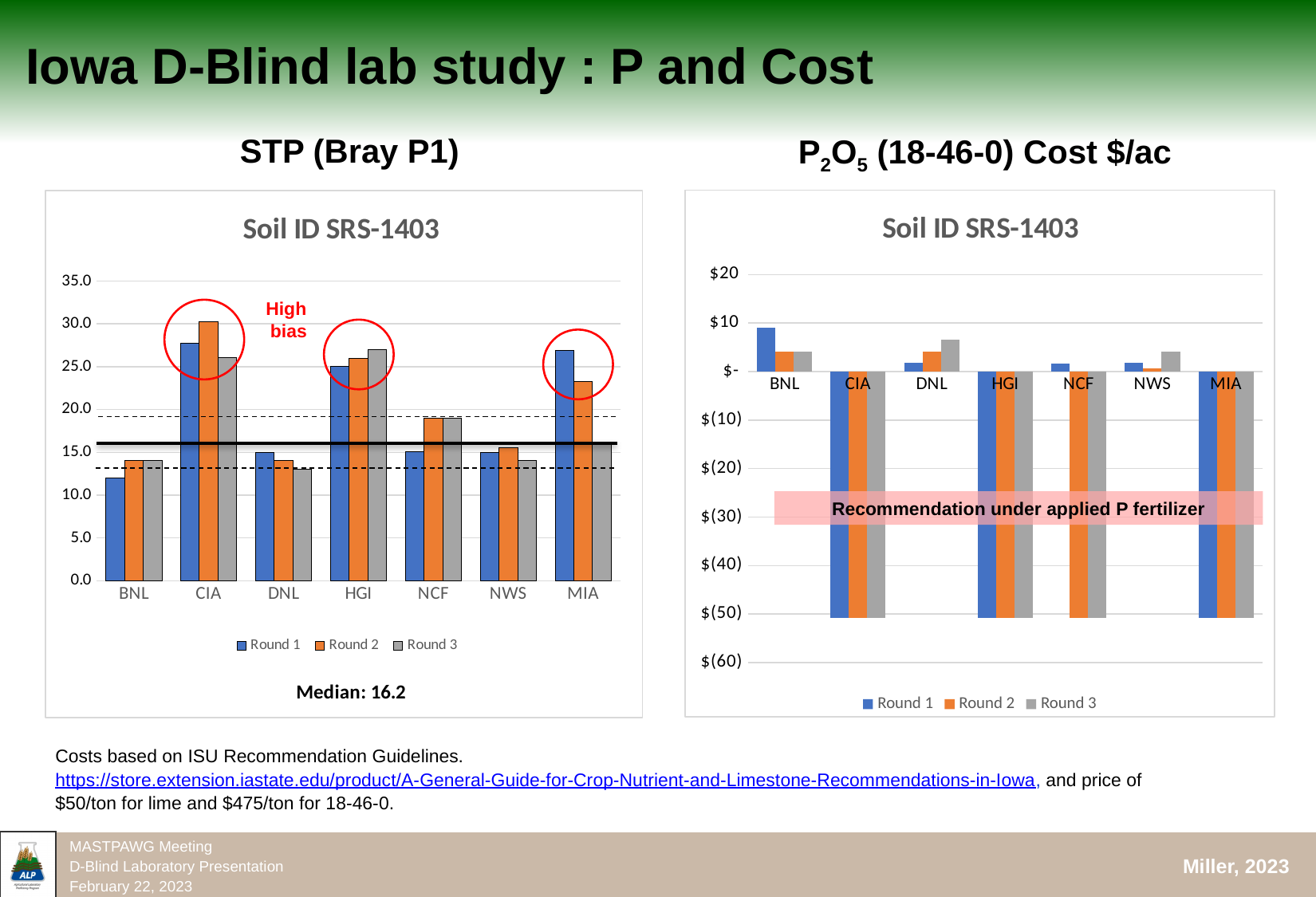
In the right chart (P2O5 Cost $/ac), is the Round 3 value for DNL greater or less than $10? less In the left chart (STP Bray P1), is the Round 2 value for CIA greater or less than 25.0? greater What is the title of the left chart (STP Bray P1)? Soil ID SRS-1403 What kind of chart is the left chart (STP Bray P1)? bar chart What median value is printed below the left chart (STP Bray P1)? 16.2 How many categories are shown on the x axis of the left chart (STP Bray P1)? 7 How many series does the legend of the right chart (P2O5 Cost $/ac) list? 3 In the left chart (STP Bray P1), which category has the highest Round 2 value? CIA In the left chart (STP Bray P1), is the Round 1 value for BNL greater or less than 15.0? less In the left chart (STP Bray P1), which is larger for NCF: the Round 1 value or the Round 2 value? Round 2 In the right chart (P2O5 Cost $/ac), which category has the highest Round 1 value? BNL In the left chart (STP Bray P1), which category has the lowest Round 1 value? BNL